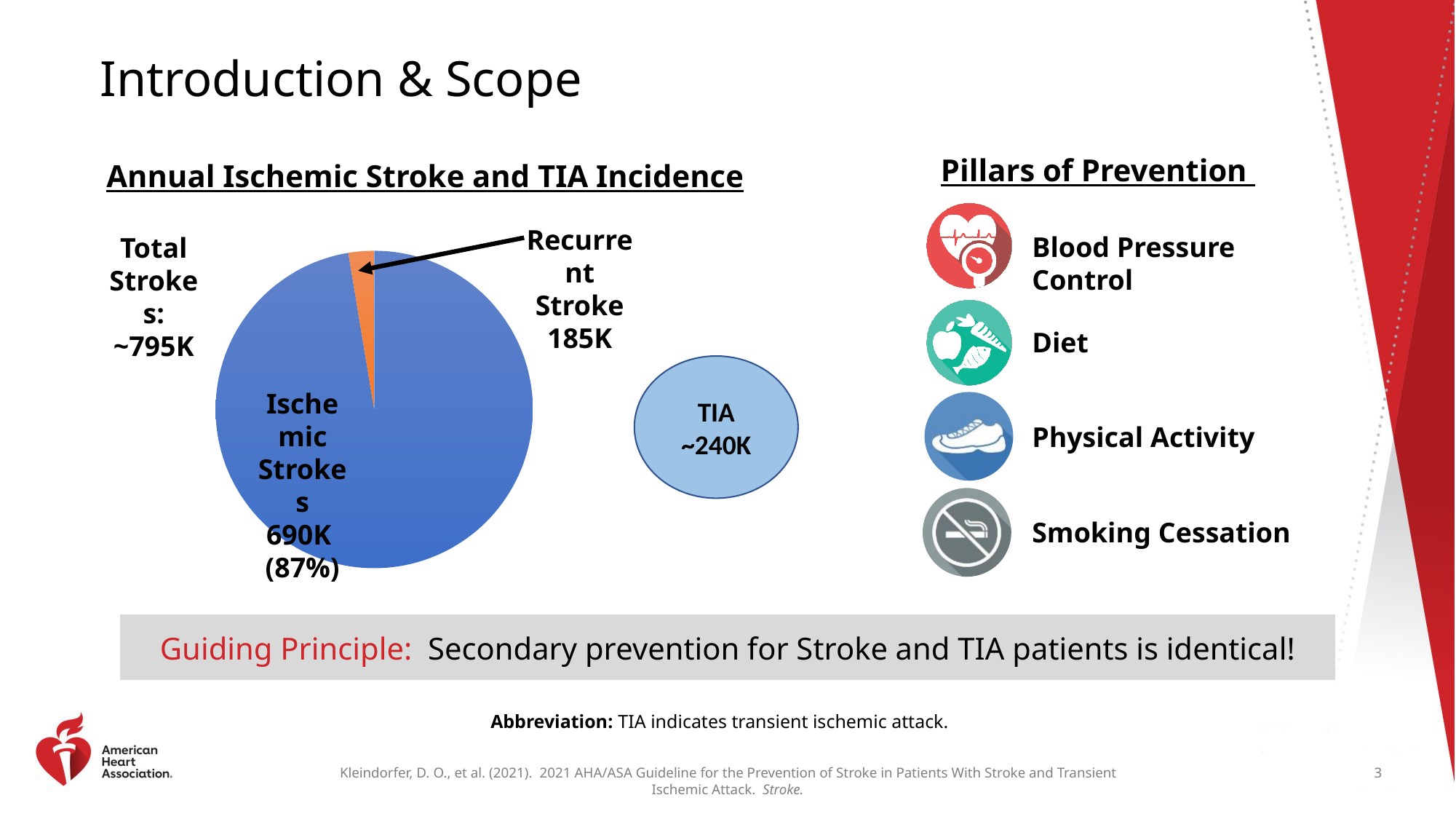
What share of the pie chart do Ischemic Strokes represent? 87% What value is labelled for Ischemic Strokes in the pie chart? 690K What value is labelled for Recurrent Stroke in the pie chart? 185K Which slice of the pie chart is the smallest? Recurrent Stroke What kind of chart is used to show Annual Ischemic Stroke and TIA Incidence? pie chart What is the title of the pie chart? Annual Ischemic Stroke and TIA Incidence What colour is the Recurrent Stroke slice of the pie chart? orange Which is larger in the pie chart, Ischemic Strokes or Recurrent Stroke? Ischemic Strokes How many slices does the pie chart have? 2 What is the difference between the labelled values for Ischemic Strokes and Recurrent Stroke? 505K Which slice of the pie chart is the largest? Ischemic Strokes